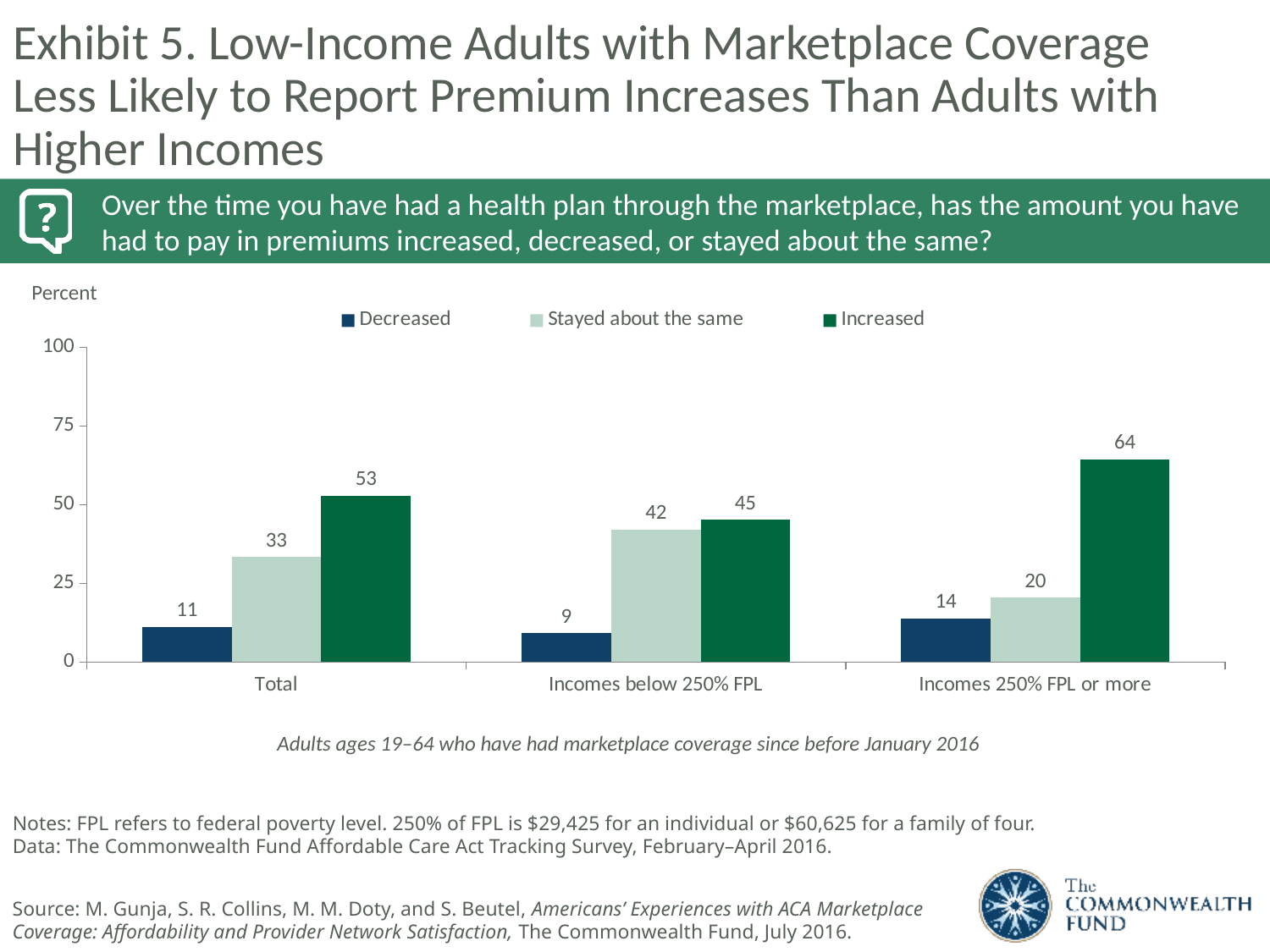
How many series does the legend list? 3 Which is larger for adults with incomes below 250% FPL: 'Stayed about the same' or 'Increased'? Increased Is the 'Increased' value for the Total group greater or less than 50? greater What kind of chart is shown on the slide? Bar chart What percentage of adults with incomes 250% FPL or more reported their premiums decreased? 14 Which income group has the highest value for 'Increased'? Incomes 250% FPL or more What is the difference between the 'Increased' values for incomes 250% FPL or more and incomes below 250% FPL? 19 What is the label on the y axis of the chart? Percent Which category has the lowest value for 'Decreased'? Incomes below 250% FPL What percentage of adults in the Total group reported their premiums increased? 53 What is the value for 'Stayed about the same' among adults with incomes below 250% FPL? 42 How many income categories are shown on the x axis? 3